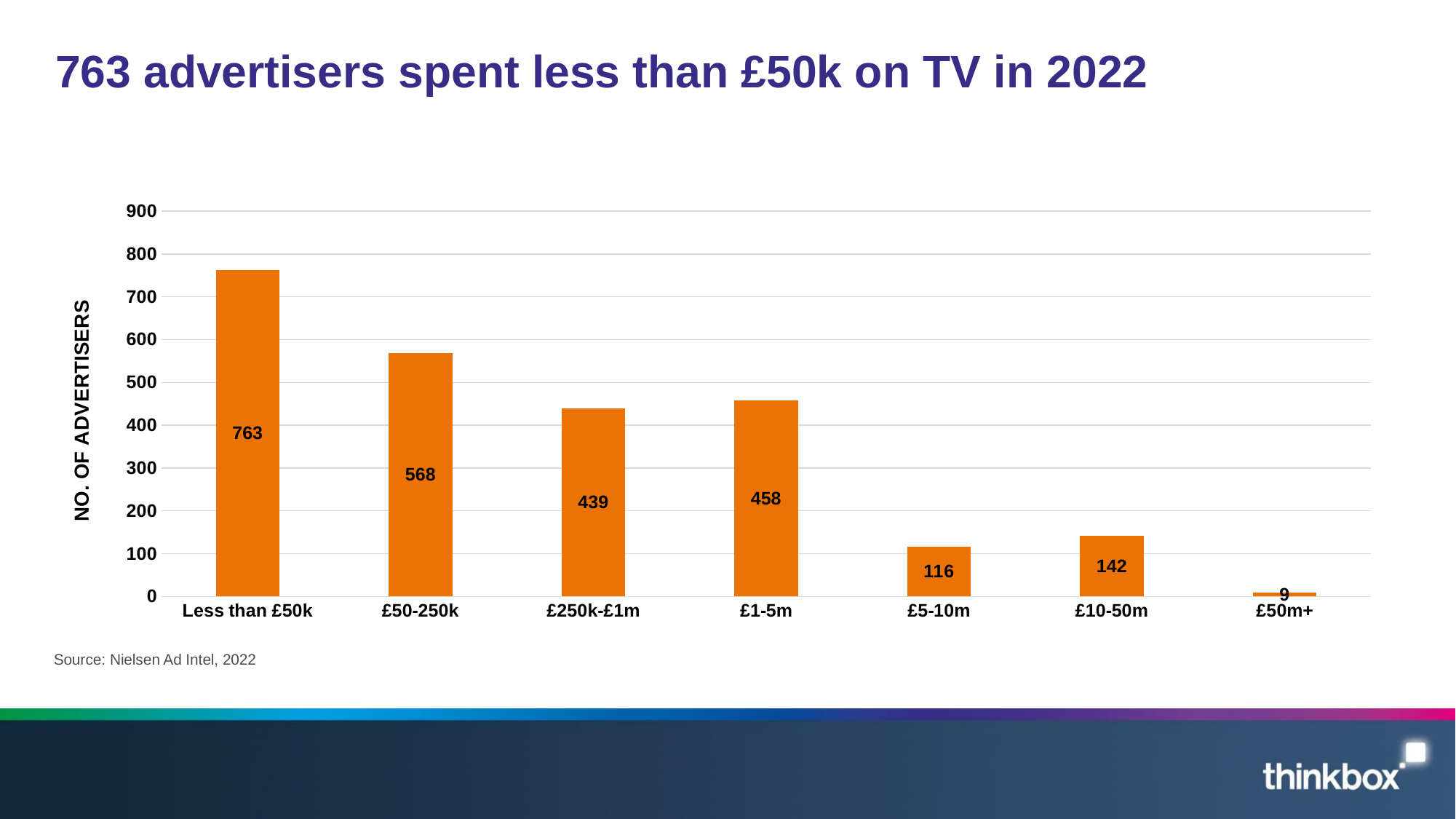
Is the number of advertisers in the £5-10m band greater or less than 200? less How many advertisers spent £50-250k on TV in 2022? 568 What is the difference in the number of advertisers between the Less than £50k band and the £50-250k band? 195 What is the number of advertisers in the £1-5m spend band? 458 Which spend band has the highest number of advertisers? Less than £50k How many spend bands are shown on the x axis? 7 Which spend band has the lowest number of advertisers? £50m+ What is the label of the vertical axis? NO. OF ADVERTISERS What is the difference in the number of advertisers between the £10-50m band and the £5-10m band? 26 Which has more advertisers: the £250k-£1m band or the £1-5m band? £1-5m How many advertisers are shown for the £50m+ band? 9 What type of chart is shown on the slide? bar chart